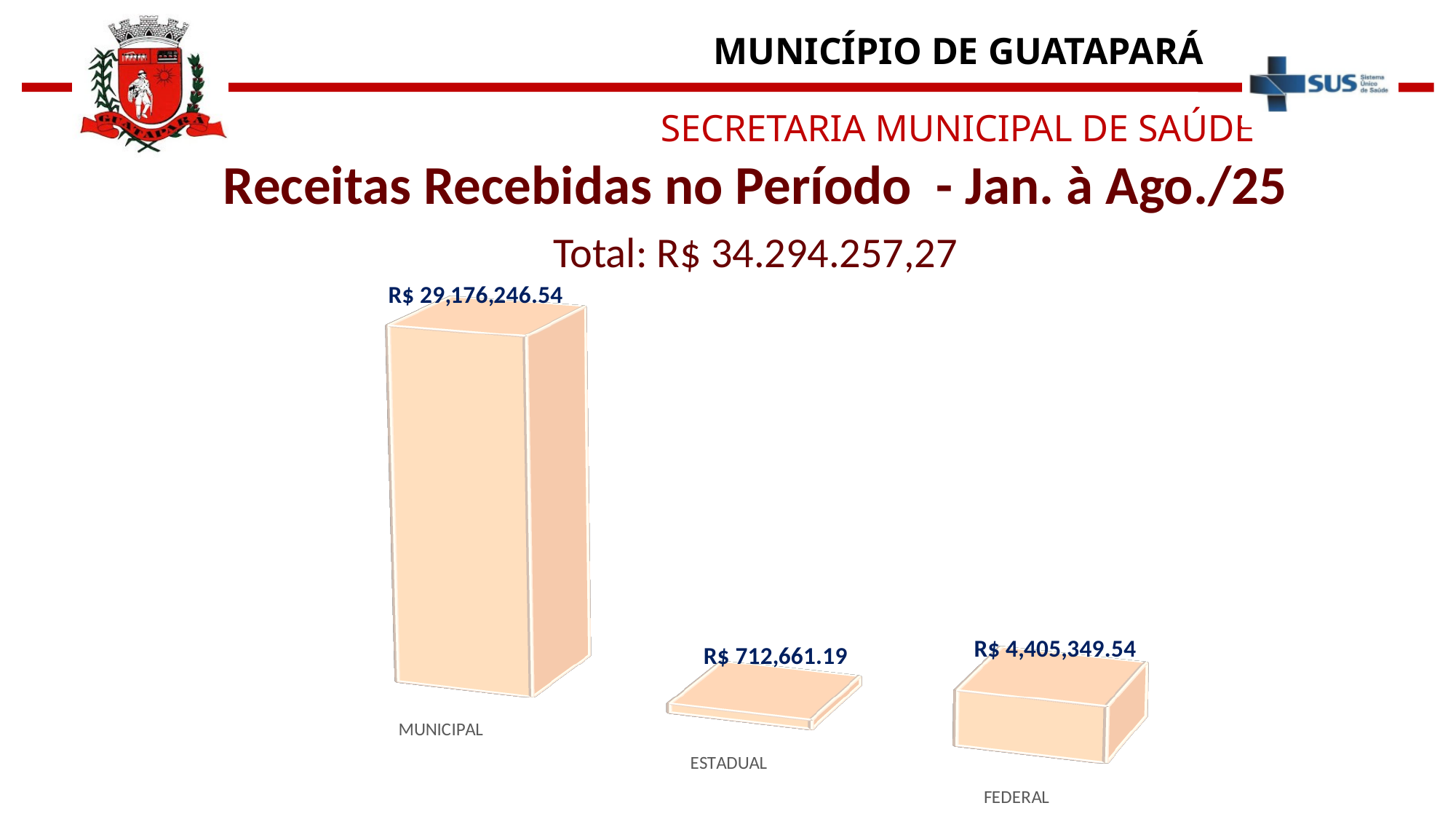
What is the difference between the MUNICIPAL and FEDERAL values? R$ 24,770,897.00 How many categories are shown in the chart? 3 Which category has the lowest value? ESTADUAL What is the value for MUNICIPAL? R$ 29,176,246.54 What is the total of the three values shown in the chart? R$ 34,294,257.27 What is the title of the chart? Receitas Recebidas no Período - Jan. à Ago./25 Which is larger, the value for FEDERAL or the value for ESTADUAL? FEDERAL Which category has the highest value? MUNICIPAL What is the difference between the FEDERAL and ESTADUAL values? R$ 3,692,688.35 What is the value for FEDERAL? R$ 4,405,349.54 What is the value for ESTADUAL? R$ 712,661.19 What kind of chart is shown on the slide? Bar chart